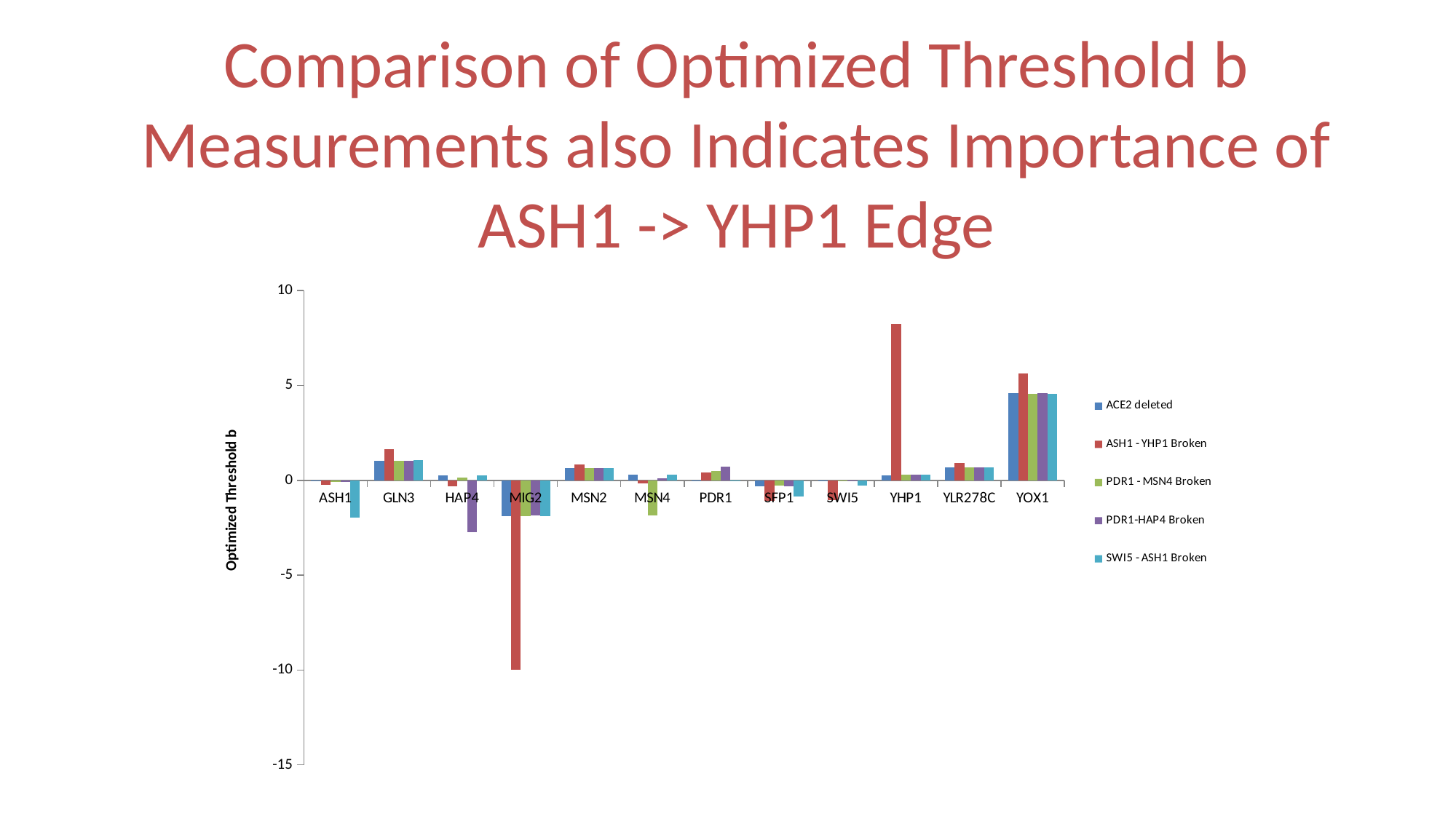
How many categories are shown on the x axis of the chart? 12 Is the SWI5 - ASH1 Broken value for ASH1 greater or less than 0? less Which series is shown in red in the chart's legend? ASH1 - YHP1 Broken What is the title of the chart's vertical axis? Optimized Threshold b What type of chart is shown on the slide? bar chart For the ASH1 - YHP1 Broken series, which is larger: the value for YHP1 or the value for YOX1? YHP1 For the ASH1 - YHP1 Broken series, which category has the lowest value? MIG2 Is the ASH1 - YHP1 Broken value for MIG2 greater or less than -5? less How many series does the chart's legend list? 5 For the ASH1 - YHP1 Broken series, which category has the highest value? YHP1 Is the ACE2 deleted value for YOX1 greater or less than 5? less